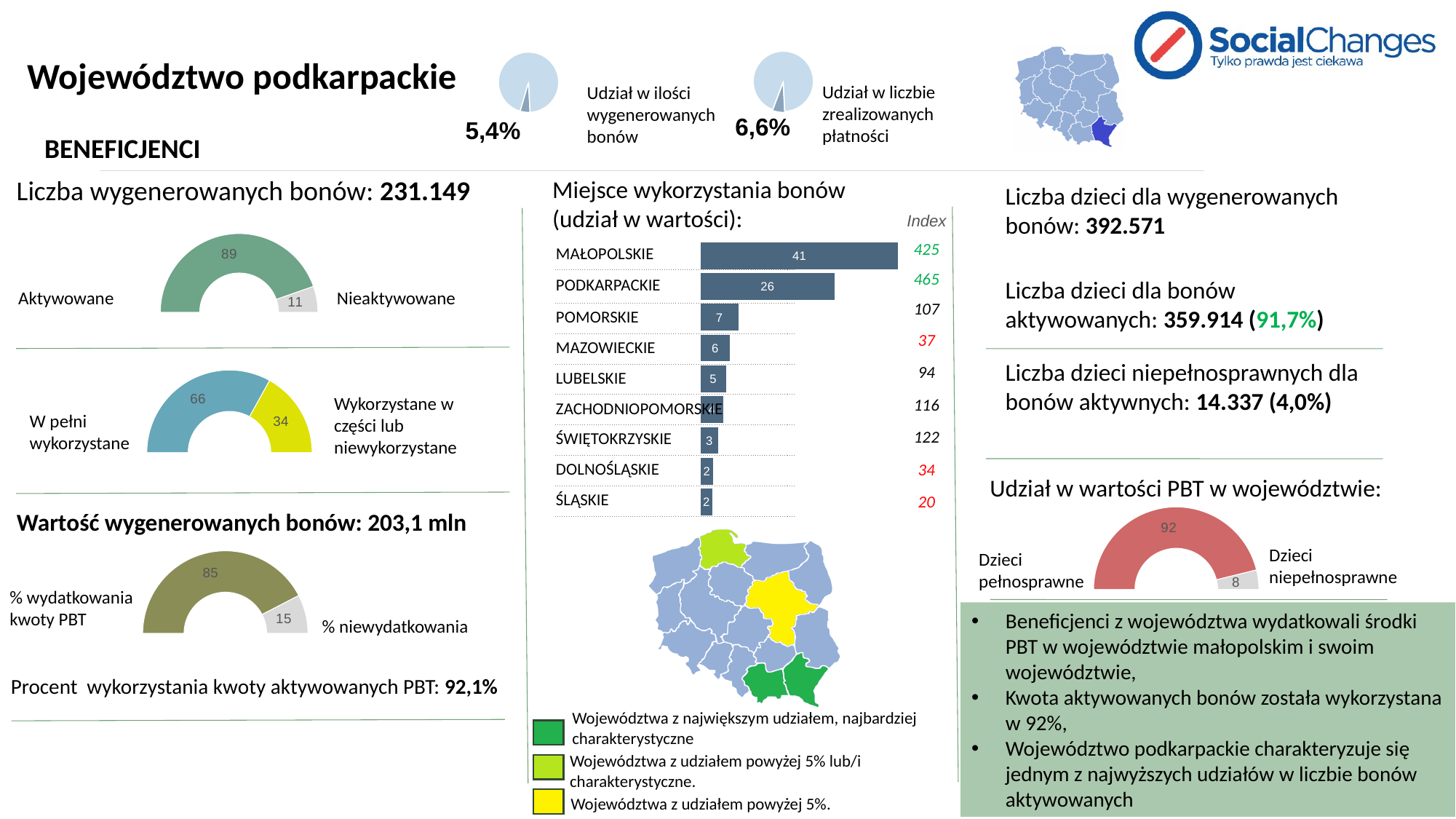
In the bar chart 'Miejsce wykorzystania bonów (udział w wartości)', what is the value for PODKARPACKIE? 26 In the bar chart 'Miejsce wykorzystania bonów (udział w wartości)', which is larger, the value for POMORSKIE or the value for LUBELSKIE? POMORSKIE In the bar chart 'Miejsce wykorzystania bonów (udział w wartości)', what is the Index value shown for PODKARPACKIE? 465 In the semi-donut chart under 'Wartość wygenerowanych bonów', what is the value for '% niewydatkowania'? 15 What kind of chart is 'Miejsce wykorzystania bonów (udział w wartości)'? bar chart In the bar chart 'Miejsce wykorzystania bonów (udział w wartości)', what is the value for MAŁOPOLSKIE? 41 In the bar chart 'Miejsce wykorzystania bonów (udział w wartości)', what is the difference between the values for MAŁOPOLSKIE and PODKARPACKIE? 15 In the chart 'Udział w wartości PBT w województwie', what is the value for 'Dzieci niepełnosprawne'? 8 How many voivodeships are listed in the bar chart 'Miejsce wykorzystania bonów (udział w wartości)'? 9 In the semi-donut chart showing 'W pełni wykorzystane' and 'Wykorzystane w części lub niewykorzystane', which segment is larger? W pełni wykorzystane In the semi-donut chart under 'Liczba wygenerowanych bonów', what is the value for Aktywowane? 89 In the bar chart 'Miejsce wykorzystania bonów (udział w wartości)', which voivodeship has the highest value? MAŁOPOLSKIE